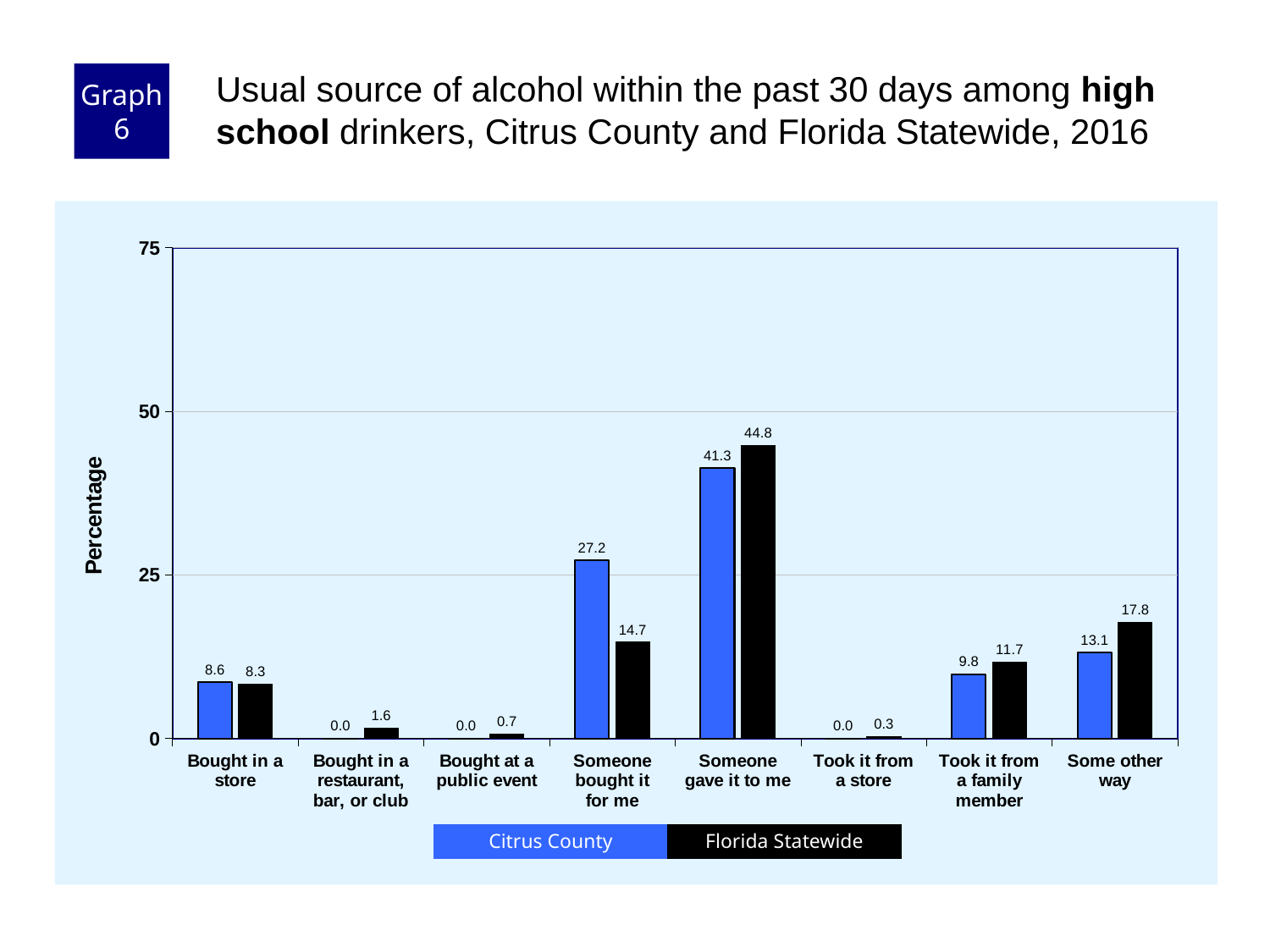
What kind of chart is shown on the slide? bar chart Which category has the lowest Florida Statewide value? Took it from a store What is the Florida Statewide value for "Took it from a store"? 0.3 How many categories are shown on the x axis? 8 What is the Citrus County value for "Someone bought it for me"? 27.2 Which is larger for "Some other way": the Citrus County value or the Florida Statewide value? Florida Statewide What is the difference between the Citrus County and Florida Statewide values for "Someone bought it for me"? 12.5 Is the Citrus County value for "Someone gave it to me" greater or less than 50? less What colour are the Florida Statewide bars? black How many series does the legend list? 2 What is the Florida Statewide value for "Someone gave it to me"? 44.8 Which category has the highest Citrus County value? Someone gave it to me